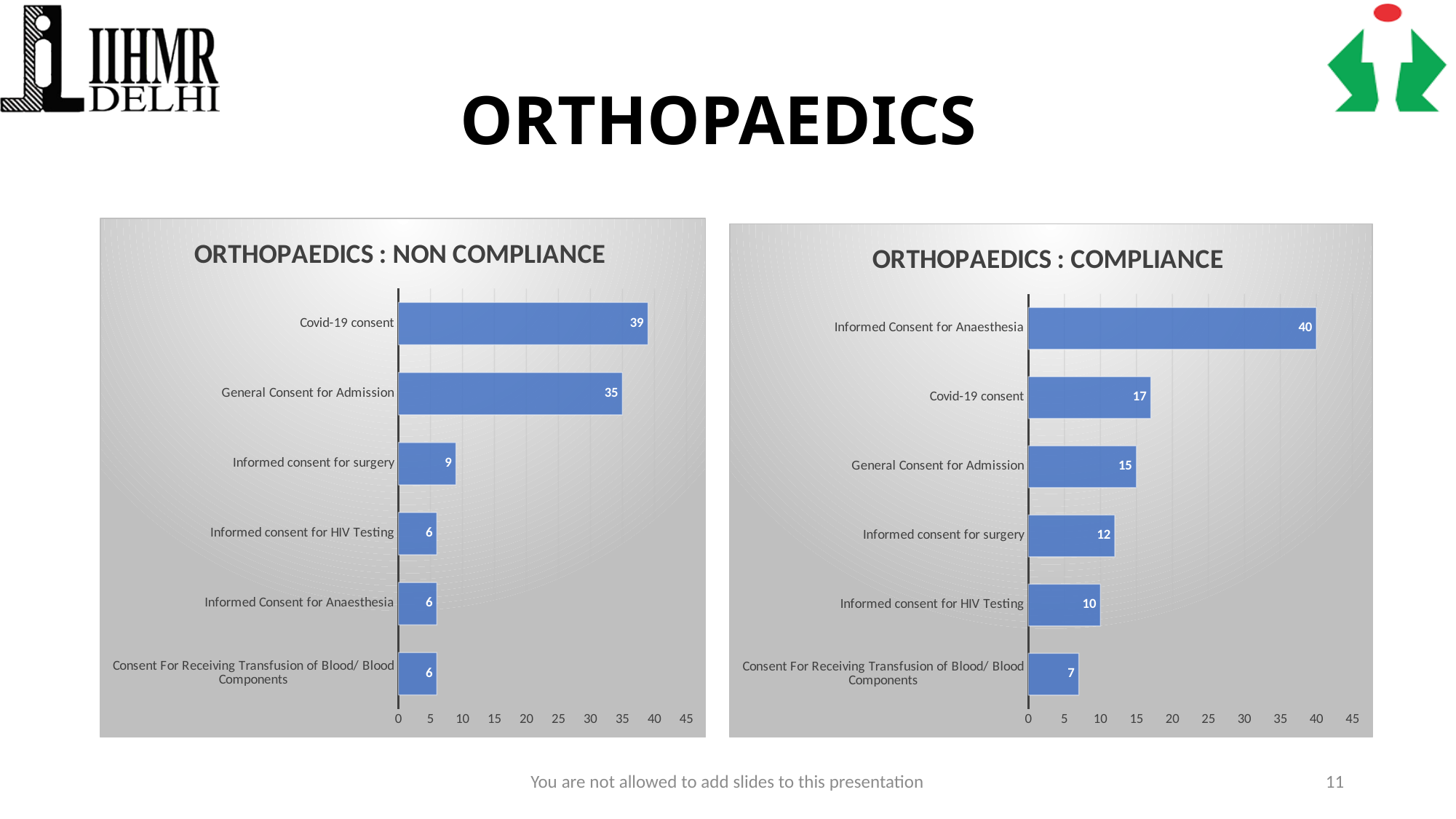
What is the title of the chart on the left side of the slide? ORTHOPAEDICS : NON COMPLIANCE What type of chart is the ORTHOPAEDICS : COMPLIANCE chart? Bar chart In the ORTHOPAEDICS : COMPLIANCE chart, what is the difference between Informed Consent for Anaesthesia and Covid-19 consent? 23 In the ORTHOPAEDICS : COMPLIANCE chart, what is the value for Informed consent for HIV Testing? 10 In the ORTHOPAEDICS : COMPLIANCE chart, which is larger: General Consent for Admission or Informed consent for surgery? General Consent for Admission How many categories are shown in the ORTHOPAEDICS : NON COMPLIANCE chart? 6 In the ORTHOPAEDICS : NON COMPLIANCE chart, what is the difference between Covid-19 consent and General Consent for Admission? 4 In the ORTHOPAEDICS : COMPLIANCE chart, which category has the lowest value? Consent For Receiving Transfusion of Blood/ Blood Components In the ORTHOPAEDICS : NON COMPLIANCE chart, what is the value for Covid-19 consent? 39 In the ORTHOPAEDICS : NON COMPLIANCE chart, which category has the highest value? Covid-19 consent In the ORTHOPAEDICS : COMPLIANCE chart, what is the value for Informed Consent for Anaesthesia? 40 In the ORTHOPAEDICS : NON COMPLIANCE chart, what is the value for Informed consent for surgery? 9